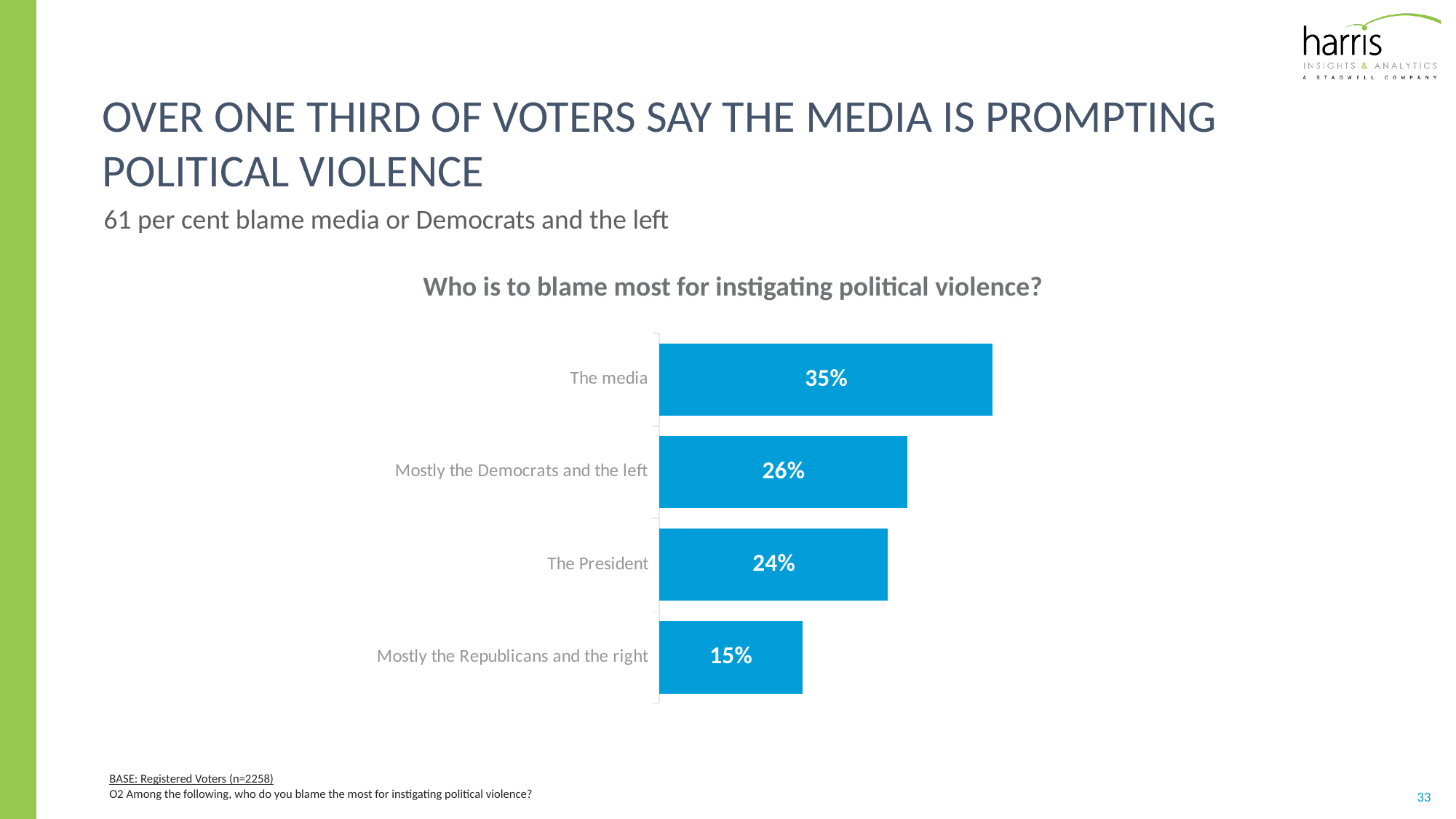
What is the difference between the value for "Mostly the Democrats and the left" and the value for "The President"? 2% What kind of chart is shown on the slide? Bar chart What is the value for "Mostly the Republicans and the right"? 15% What is the value for "The President"? 24% How many categories are shown in the chart? 4 What percentage of voters say the media is most to blame for instigating political violence? 35% What is the title of the chart? Who is to blame most for instigating political violence? Which category has the highest value? The media What is the value for "Mostly the Democrats and the left"? 26% What is the difference between the value for "The media" and the value for "Mostly the Republicans and the right"? 20% Which is larger: the value for "The President" or the value for "Mostly the Republicans and the right"? The President Which category has the lowest value? Mostly the Republicans and the right